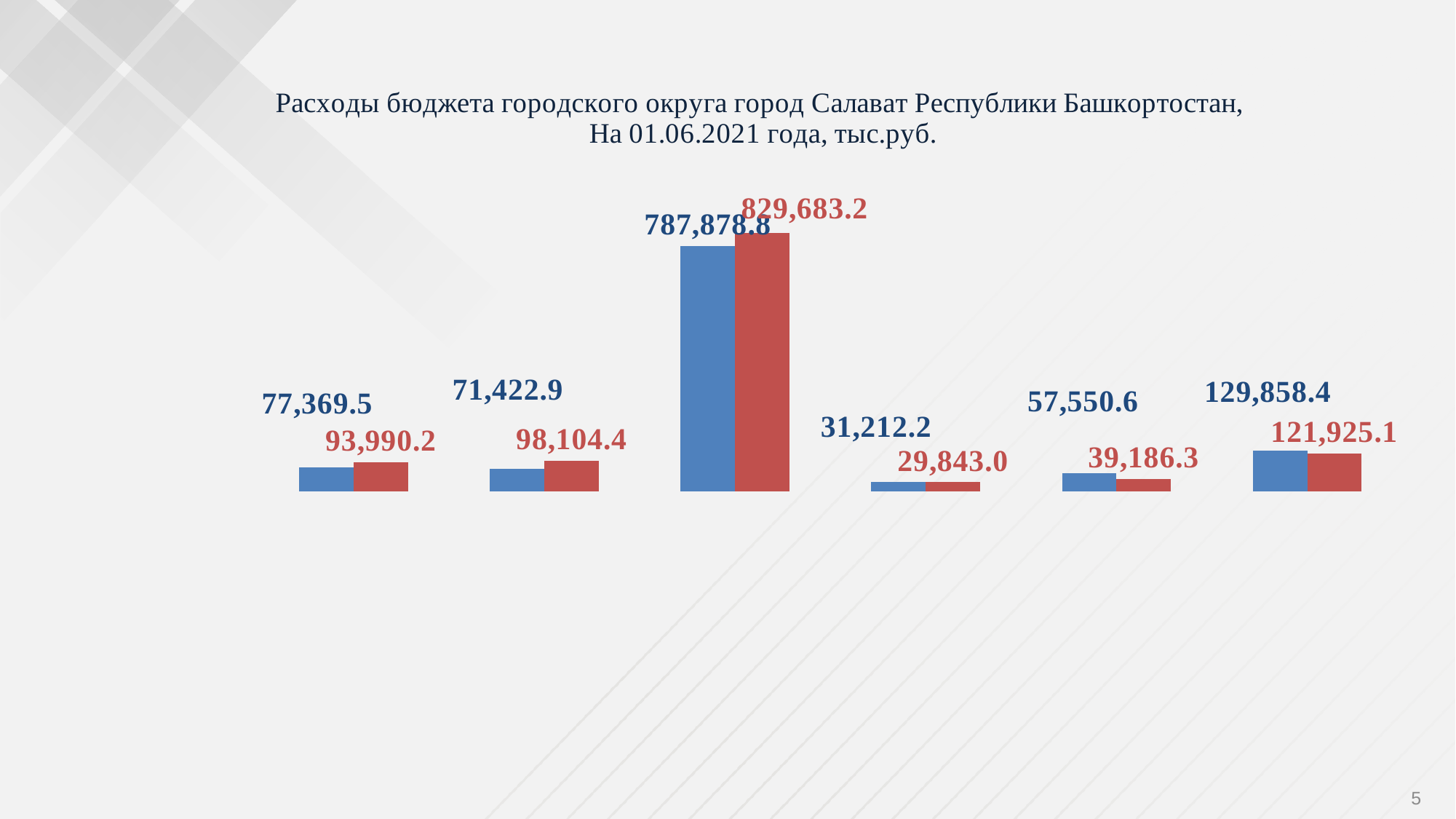
What is the value of the blue bar in the third (tallest) group of bars? 787,878.8 Which blue bar has the lowest value, and what is it? The fourth group, 31,212.2 What is the value of the blue bar in the rightmost group of bars? 129,858.4 What is the value of the red bar in the first group of bars from the left? 93,990.2 How many groups of bars are plotted on the chart? 6 What kind of chart is shown on the slide? bar chart In the fifth group of bars from the left, which is larger, the blue bar or the red bar? the blue bar What is the highest value shown on the chart? 829,683.2 What is the title of the chart? Расходы бюджета городского округа город Салават Республики Башкортостан, На 01.06.2021 года, тыс.руб. What is the value of the red bar in the third (tallest) group of bars? 829,683.2 In the rightmost group, how much larger is the blue bar than the red bar? 7,933.3 In the third (tallest) group, what is the difference between the red bar and the blue bar? 41,804.4